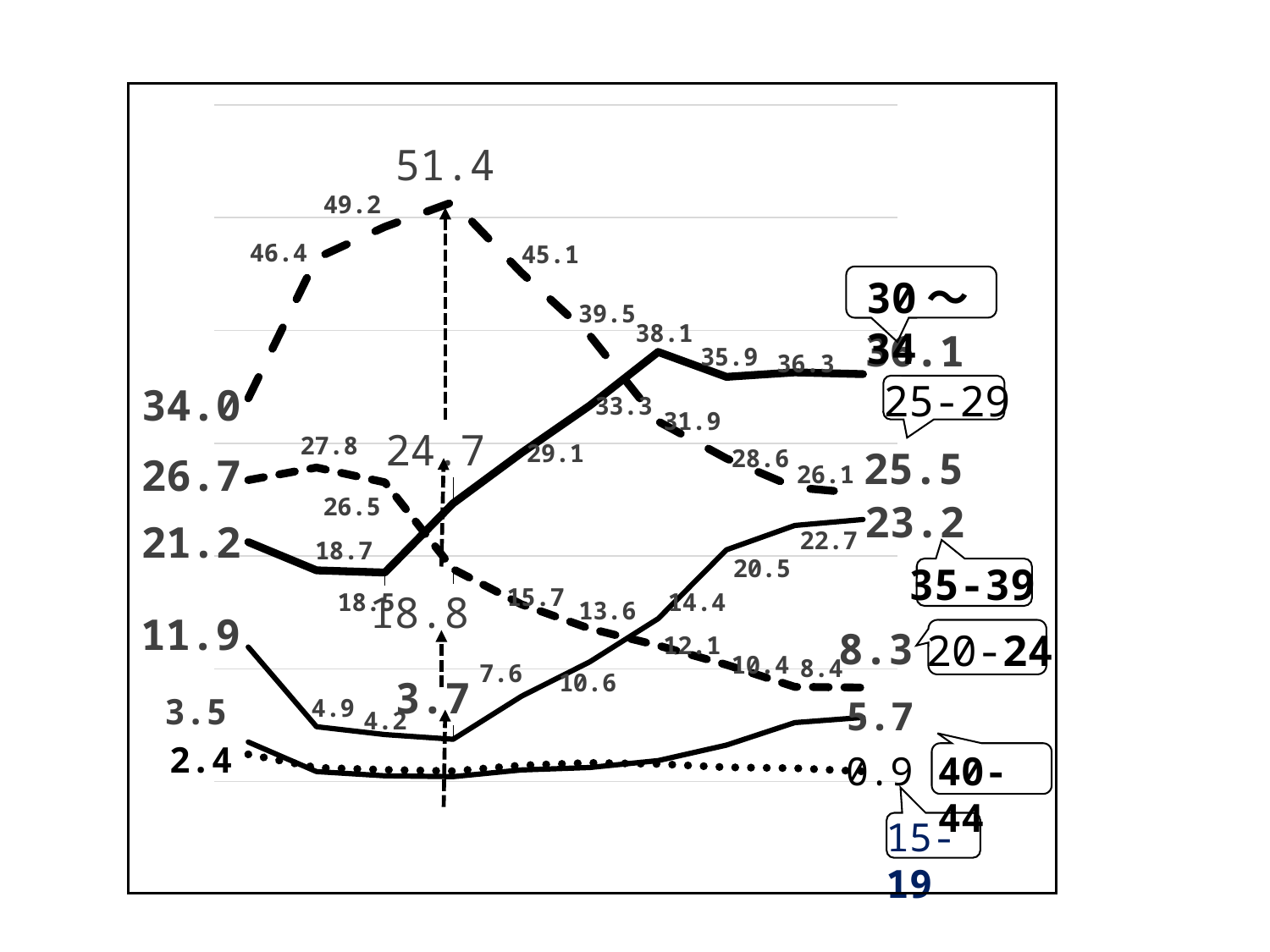
What is the final (rightmost) value of the 15-19 series? 0.9 At the right end of the chart, which is larger: the 30~ series or the 25-29 series? 30~ What is the first (leftmost) value of the 20-24 series? 26.7 What is the final (rightmost) value of the 30~ series? 36.1 What is the highest value reached by the 25-29 series? 51.4 What is the final (rightmost) value of the 35-39 series? 23.2 What kind of chart is shown on the slide? line chart Which series has the lowest value at the right end of the chart? 15-19 Does the 20-24 series rise or fall from left to right across the chart? fall How many series (age groups) are labelled on the chart? 6 What is the final (rightmost) value of the 25-29 series? 25.5 What is the difference between the final values of the 30~ series (36.1) and the 25-29 series (25.5)? 10.6